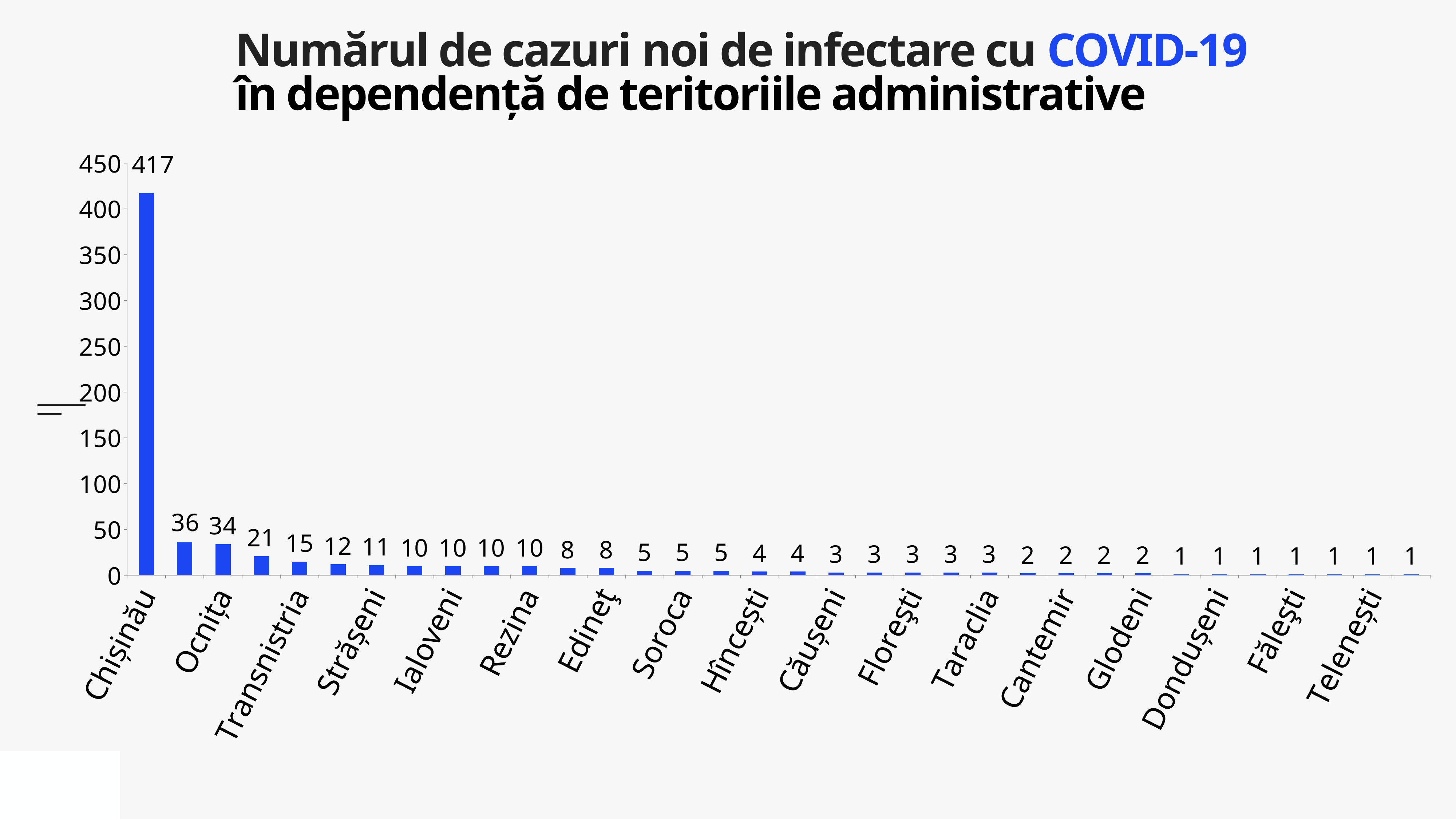
How many bars are plotted on the chart? 34 Do the values rise or fall from left to right along the x axis? fall What is the highest tick value shown on the vertical axis? 450 What colour are the bars on the chart? blue Is the value for Transnistria greater or less than 50? less Which is larger, the value for Chișinău or the value for Ocnița? Chișinău What is the lowest value shown on the chart? 1 What type of chart is shown on the slide? bar chart How many new COVID-19 cases are shown for Chișinău? 417 Is the value for Ocnița greater or less than 50? less Which territory has the highest number of new COVID-19 cases? Chișinău Is the value for Chișinău greater or less than 400? greater